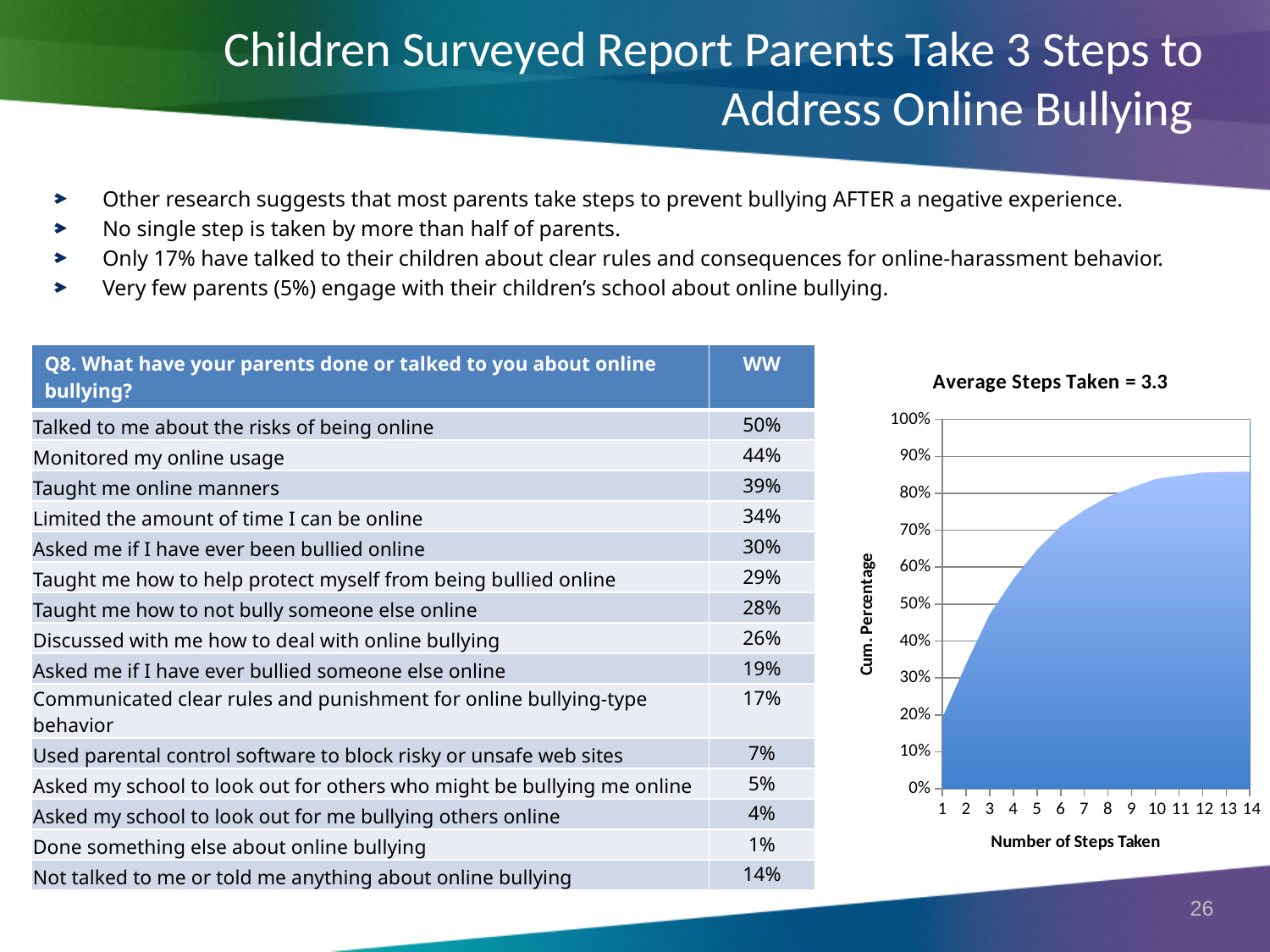
What kind of chart is shown on the right of the slide? area chart In the chart, is the cumulative percentage at 1 step taken greater or less than 30%? less In the chart, is the cumulative percentage at 3 steps taken greater or less than 40%? greater In the chart, is the cumulative percentage at 12 steps taken greater or less than 80%? greater How many values for Number of Steps Taken are shown on the x axis of the chart? 14 What is the title of the chart on the right of the slide? Average Steps Taken = 3.3 In the chart, which number of steps taken has the lowest cumulative percentage? 1 In the chart, which number of steps taken has the highest cumulative percentage? 14 In the chart titled "Average Steps Taken = 3.3", does the cumulative percentage rise or fall as the number of steps taken increases? rises